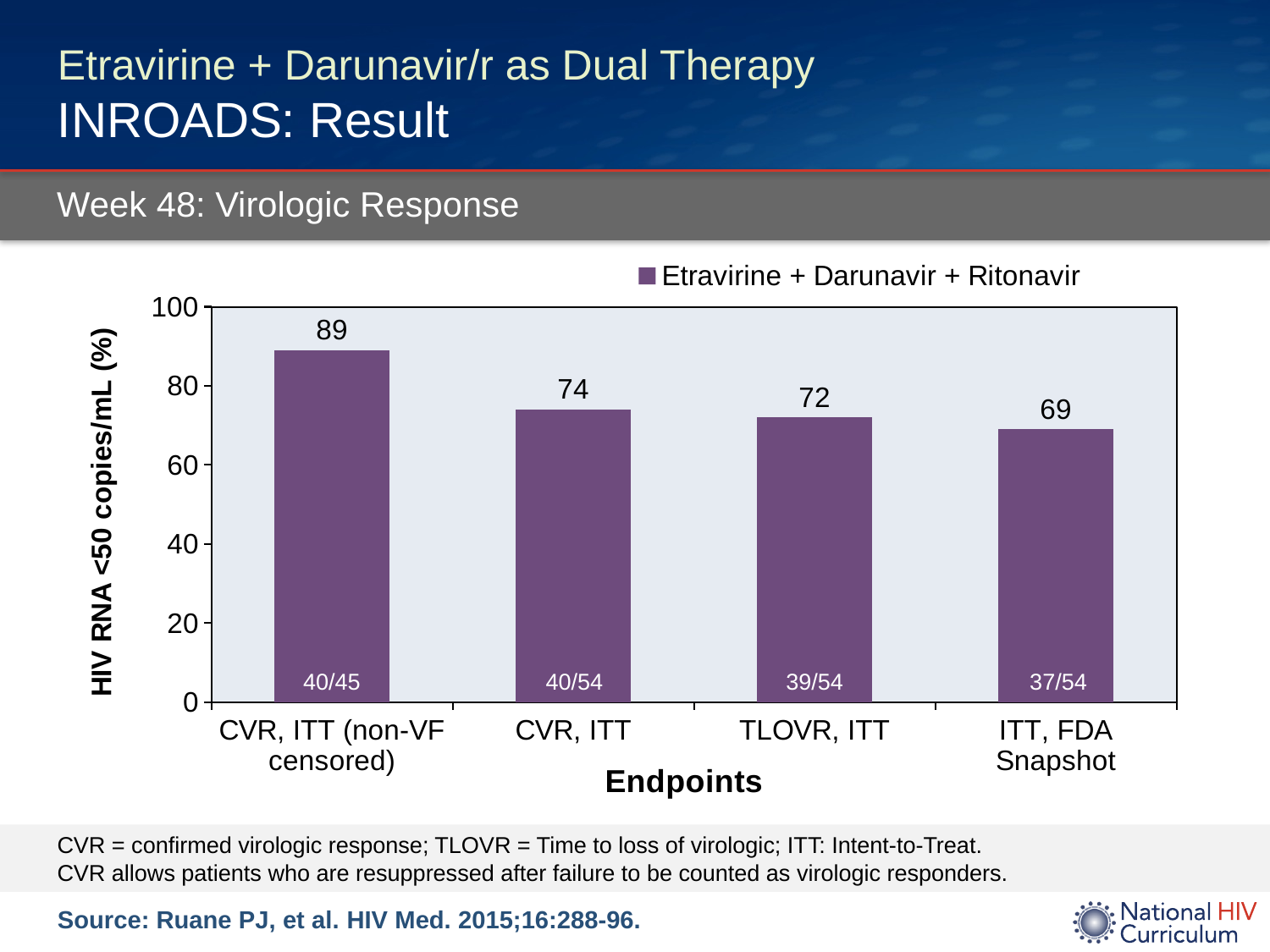
How many series does the legend list? 1 Which is larger, the value for CVR, ITT or the value for ITT, FDA Snapshot? CVR, ITT Do the values rise or fall from left to right along the x axis? Fall What is the value for CVR, ITT (non-VF censored)? 89 What is the difference between the values for TLOVR, ITT and ITT, FDA Snapshot? 3 What is the value for TLOVR, ITT? 72 Which endpoint has the lowest value? ITT, FDA Snapshot What is the difference between the values for CVR, ITT (non-VF censored) and CVR, ITT? 15 What kind of chart is shown? Bar chart What is the value for ITT, FDA Snapshot? 69 Which endpoint has the highest value? CVR, ITT (non-VF censored) How many endpoints are shown on the x axis? 4